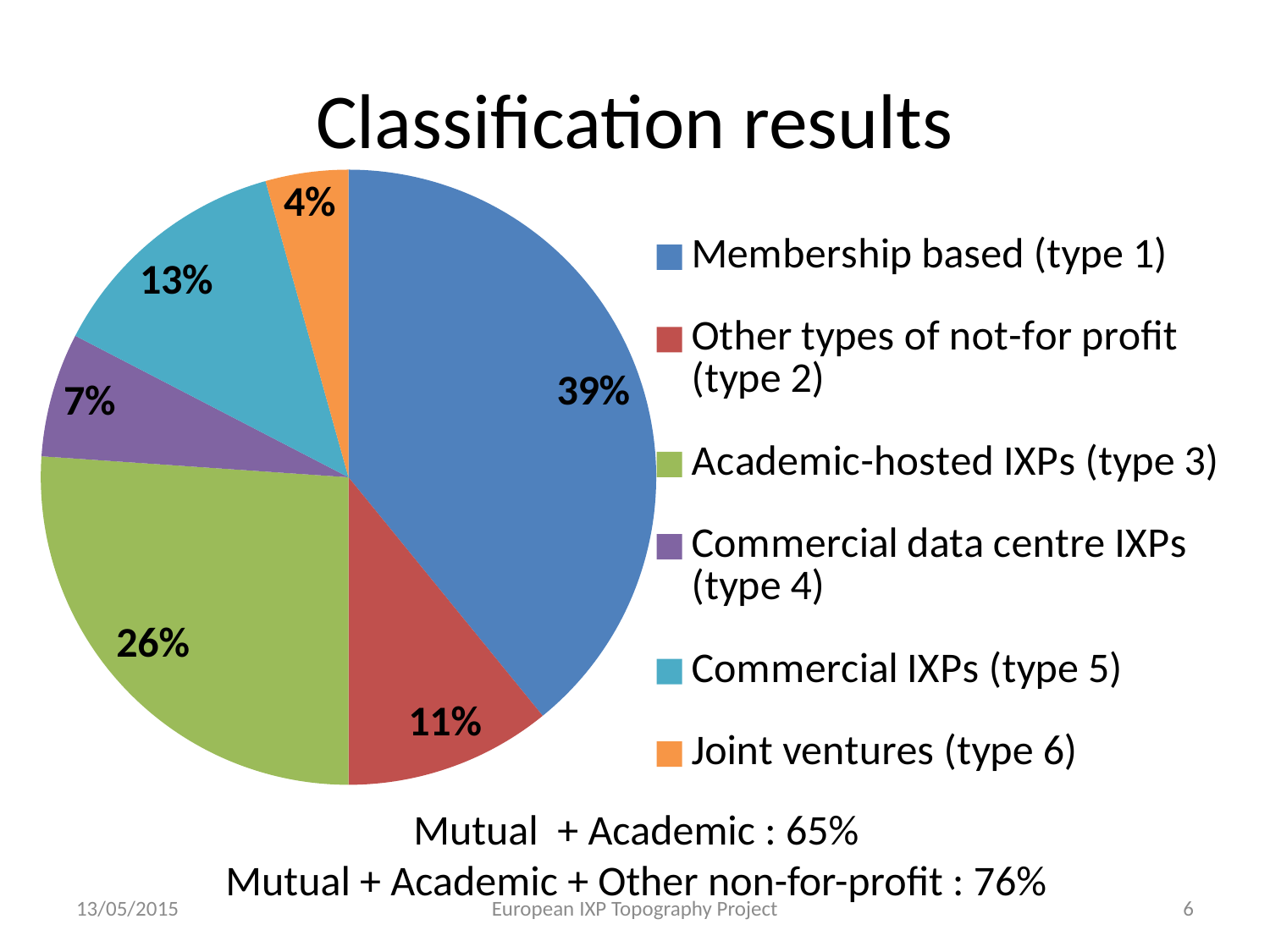
What is the title of the slide containing the chart? Classification results How many categories does the pie chart show? 6 Which category has the largest slice of the pie? Membership based (type 1) What kind of chart is shown on the slide? Pie chart Which category has the smallest slice of the pie? Joint ventures (type 6) What is the value shown for Other types of not-for profit (type 2)? 11% Which is larger, the share for Commercial IXPs (type 5) or the share for Other types of not-for profit (type 2)? Commercial IXPs (type 5) What is the value shown for Commercial IXPs (type 5)? 13% What share of the pie does Membership based (type 1) hold? 39% What is the value shown for Academic-hosted IXPs (type 3)? 26% What is the value shown for Commercial data centre IXPs (type 4)? 7% What is the difference between the shares of Membership based (type 1) and Academic-hosted IXPs (type 3)? 13%